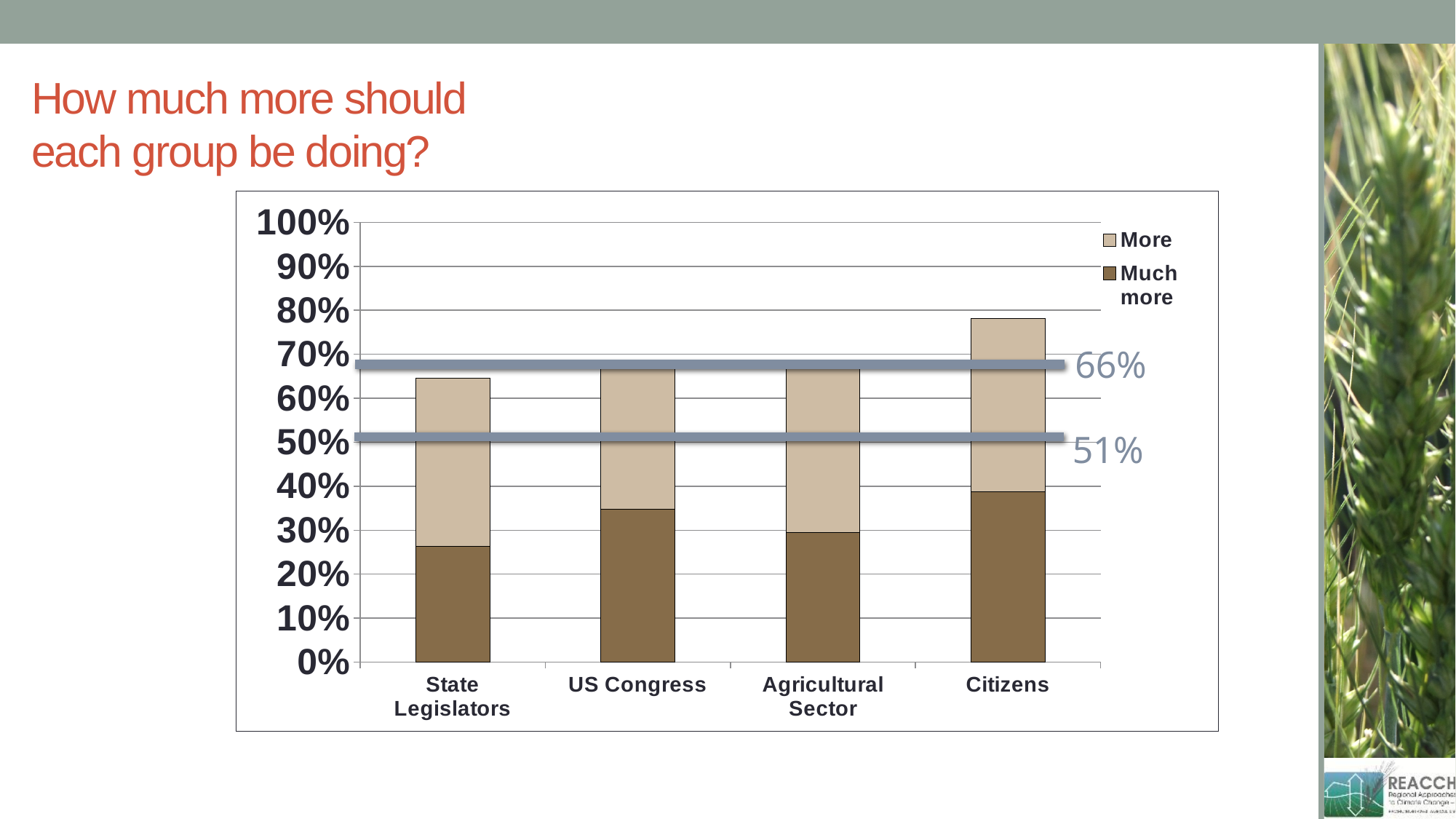
Is the total stacked bar for Citizens greater or less than 70%? greater Is the 'Much more' value for US Congress greater or less than 30%? greater What kind of chart is shown on the slide? Stacked bar chart Which group has the largest 'Much more' segment? Citizens Which has the taller total stacked bar, Citizens or State Legislators? Citizens How many series does the chart's legend list? 2 How many groups (categories) are shown on the x axis of the chart? 4 What are the two series named in the chart's legend? More and Much more Is the 'Much more' value for State Legislators greater or less than 30%? less Which group has the smallest 'Much more' segment? State Legislators Which group has the tallest stacked bar overall? Citizens